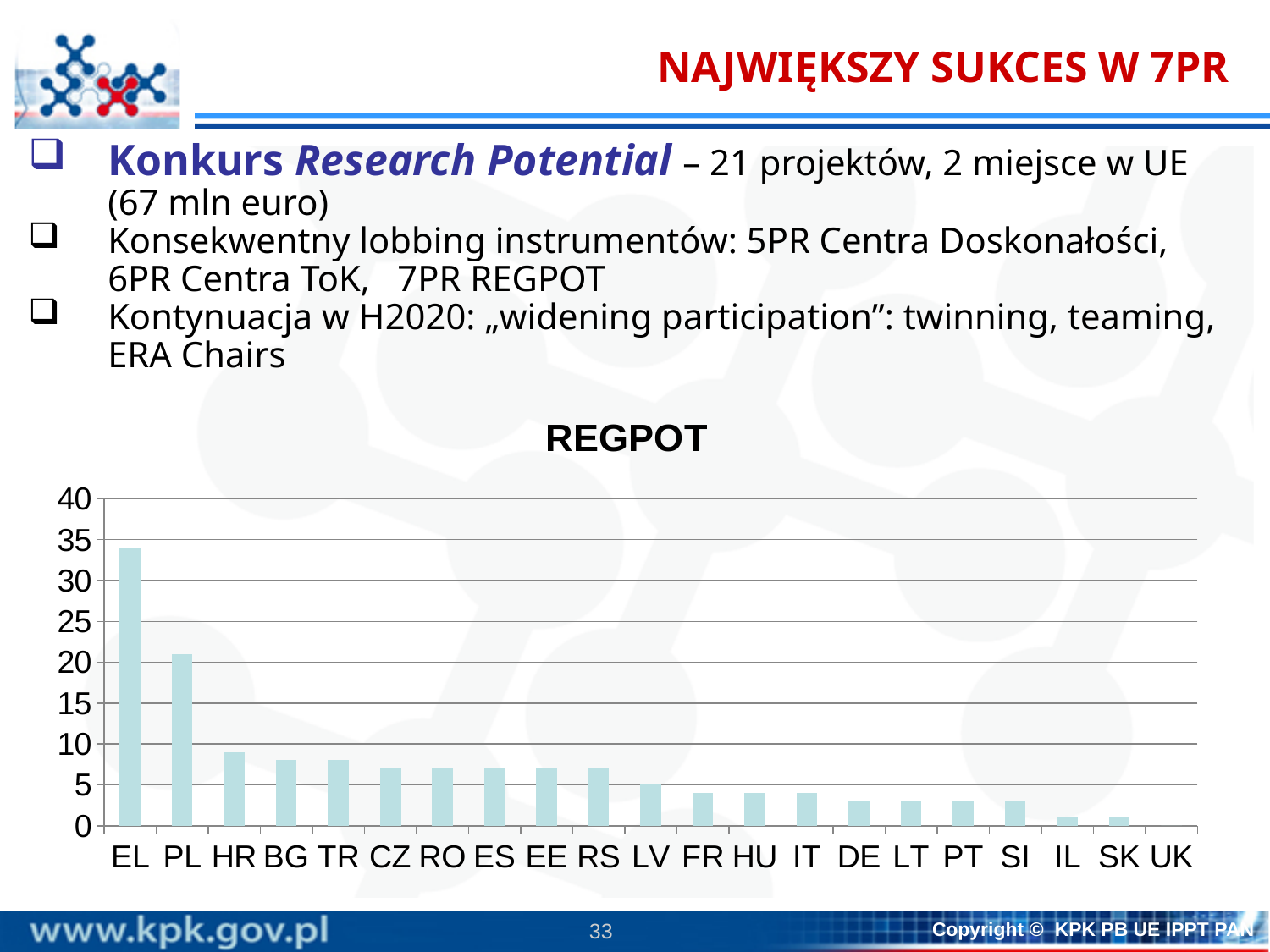
Is the value for PL greater or less than 20? greater How many countries are shown on the x axis of the REGPOT chart? 21 Is the value for HR greater or less than 10? less Which country has the lowest value in the REGPOT chart? UK Is the value for EL greater or less than 30? greater Which country has the highest value in the REGPOT chart? EL What kind of chart is the REGPOT chart? bar chart Do the values in the REGPOT chart generally rise or fall from left to right along the x axis? fall Which has a larger value, HR or DE? HR What is the title of the chart on the slide? REGPOT Which has a larger value, EL or PL? EL